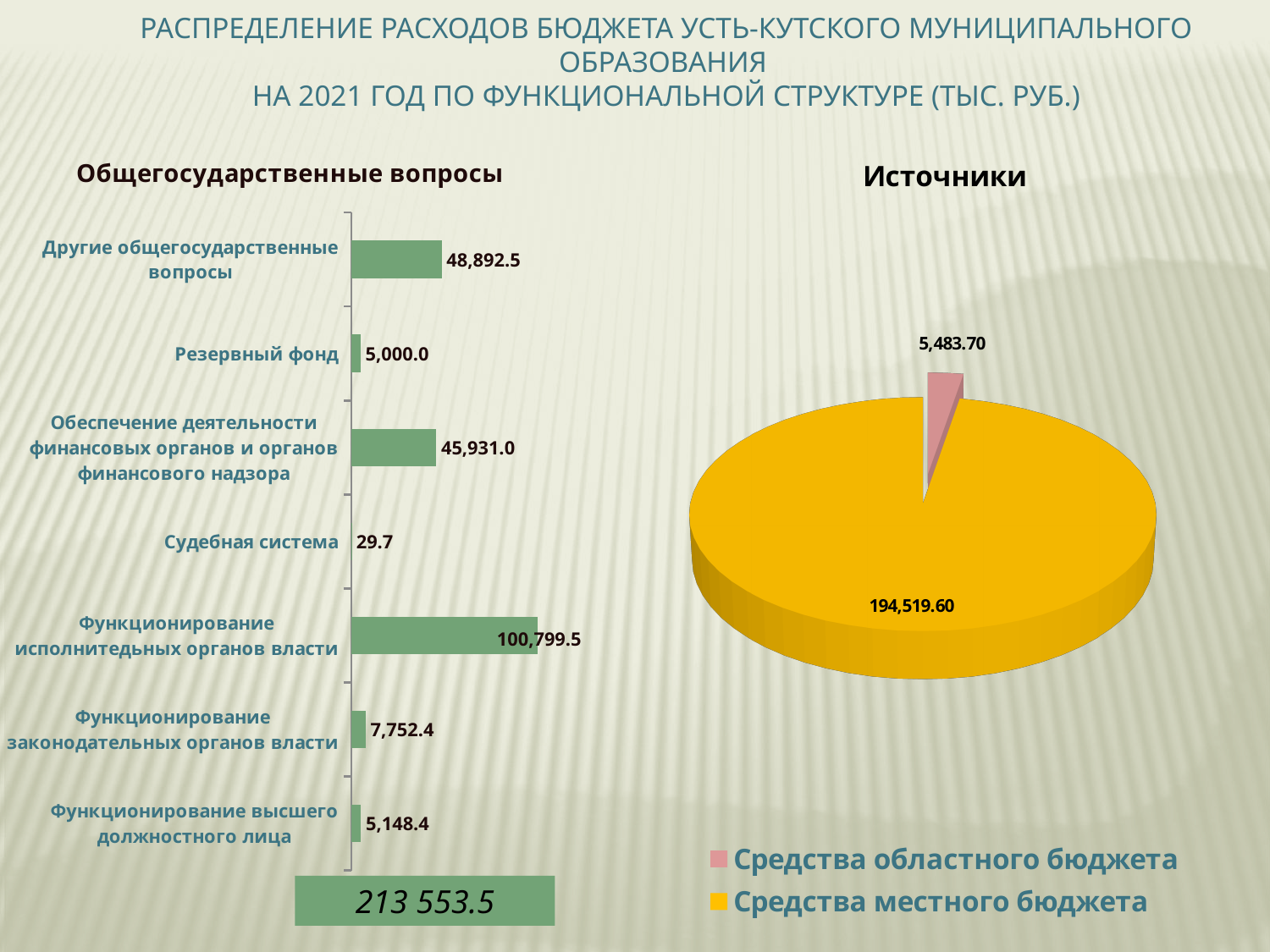
In the chart 'Общегосударственные вопросы', what is the difference between 'Функционирование исполнительных органов власти' and 'Другие общегосударственные вопросы'? 51,907.0 What type of chart is 'Источники'? Pie chart What type of chart is 'Общегосударственные вопросы'? Bar chart In the chart 'Общегосударственные вопросы', what is the value for 'Судебная система'? 29.7 In the chart 'Общегосударственные вопросы', which is larger: 'Другие общегосударственные вопросы' or 'Обеспечение деятельности финансовых органов и органов финансового надзора'? Другие общегосударственные вопросы In the chart 'Общегосударственные вопросы', what is the value for 'Функционирование исполнительных органов власти'? 100,799.5 How many categories are shown in the chart 'Общегосударственные вопросы'? 7 In the chart 'Общегосударственные вопросы', which category has the lowest value? Судебная система In the chart 'Источники', what is the value for 'Средства местного бюджета'? 194,519.60 In the chart 'Источники', what is the value for 'Средства областного бюджета'? 5,483.70 In the chart 'Общегосударственные вопросы', which category has the highest value? Функционирование исполнительных органов власти How many entries does the legend of the chart 'Источники' list? 2